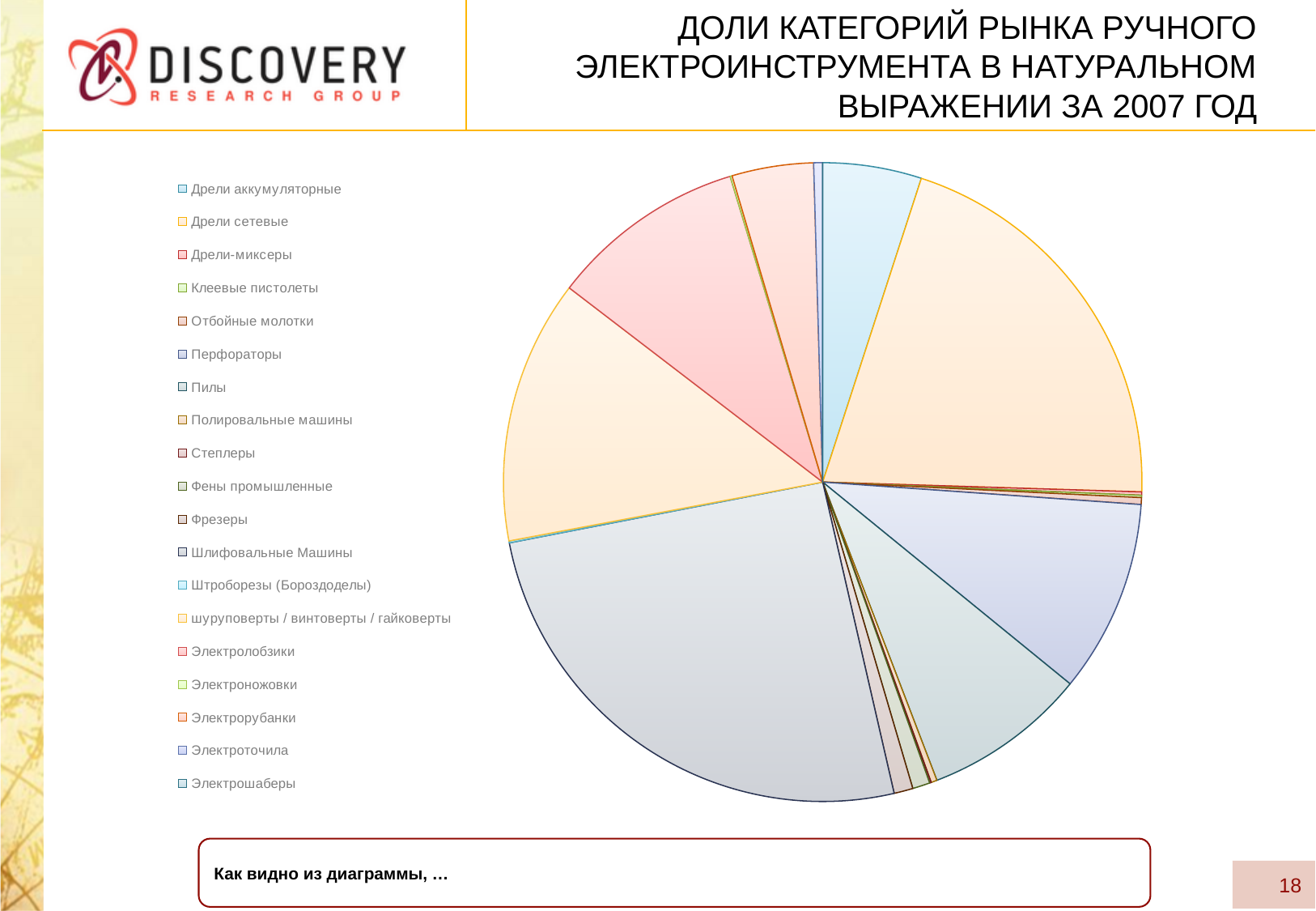
Which category is listed first in the chart legend? Дрели аккумуляторные What kind of chart is shown on the slide? Pie chart Which slice is larger: Перфораторы or Дрели аккумуляторные? Перфораторы Which category has the largest slice of the pie chart? Шлифовальные Машины How many categories does the legend of the pie chart list? 19 Which slice is larger: Дрели сетевые or Перфораторы? Дрели сетевые Which slice is larger: Дрели сетевые or Дрели аккумуляторные? Дрели сетевые What year does the chart title say the data refers to? 2007